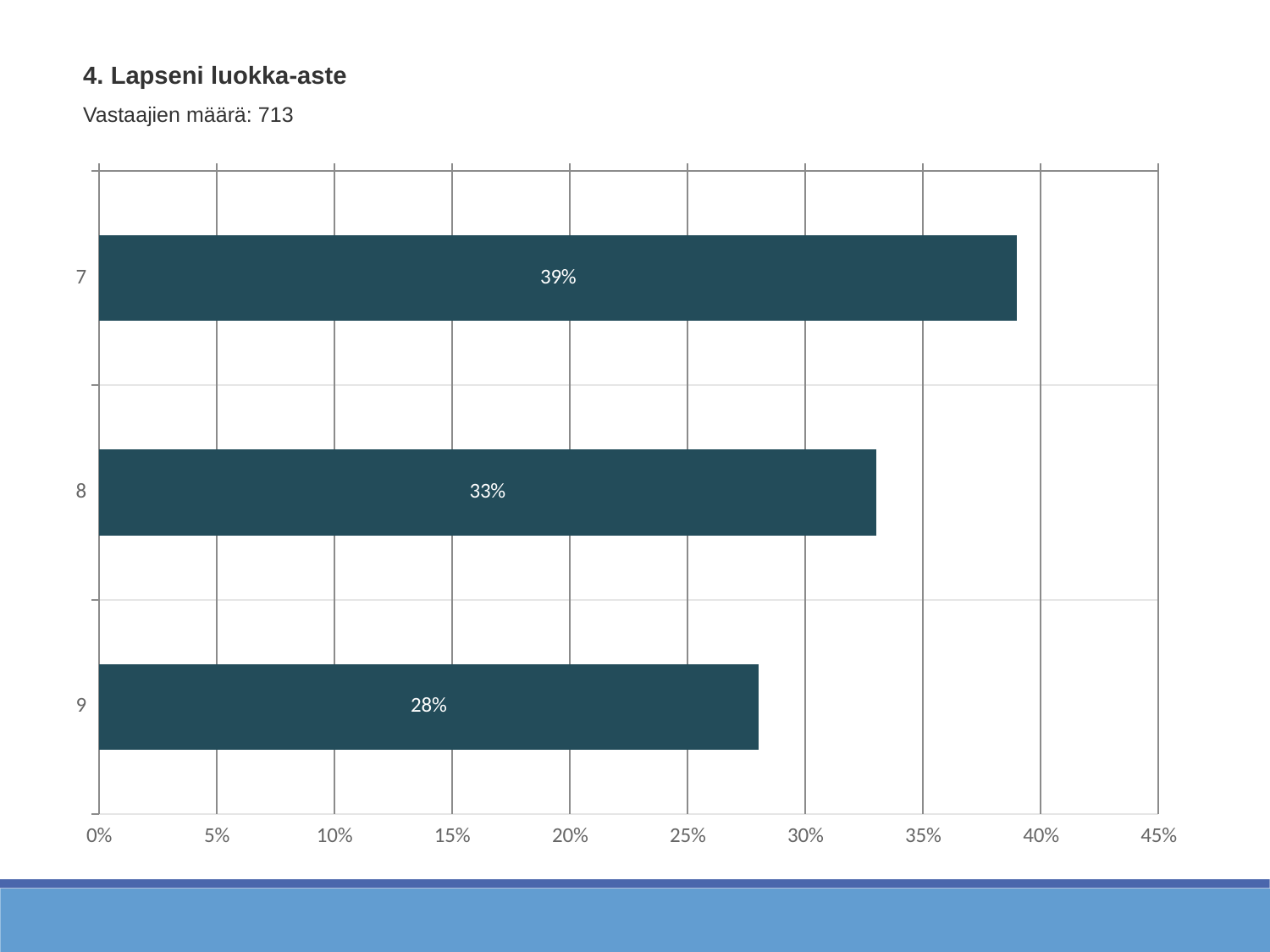
What is the difference between the values for category 7 and category 8? 6% Which category has the lowest value? 9 Which category has the highest value? 7 How many categories are shown in the chart? 3 What kind of chart is shown on the slide? bar chart Which is larger, the value for category 8 or the value for category 9? 8 What is the difference between the values for category 7 and category 9? 11% What is the value for category 7? 39% What is the value for category 9? 28% Is the value for category 8 greater or less than 30%? greater What is the value for category 8? 33% What is the title of the chart? 4. Lapseni luokka-aste